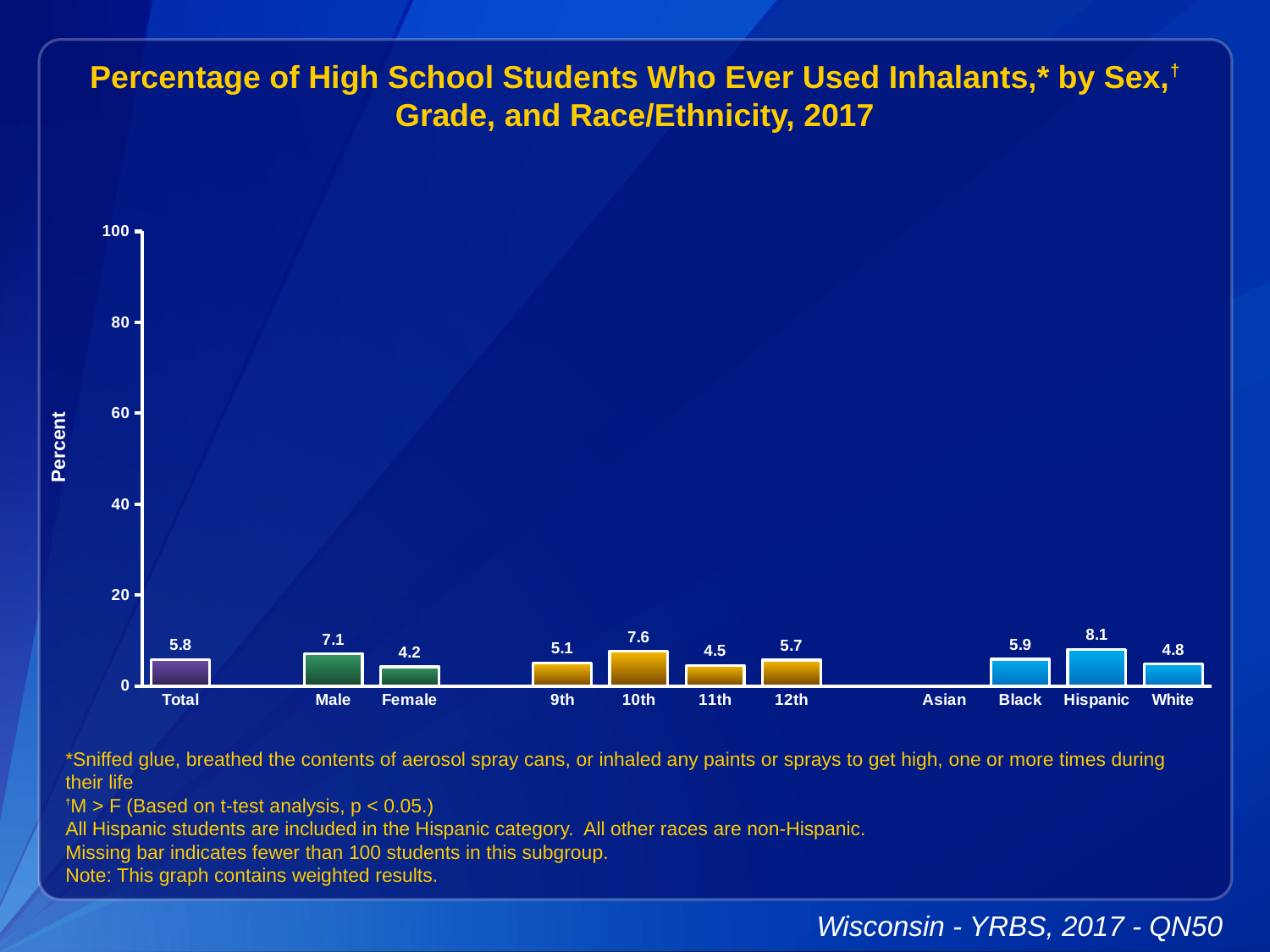
How many categories have a bar plotted? 10 Is the value for Black greater or less than 20? less What is the value for Hispanic? 8.1 What is the value for 10th grade? 7.6 What is the difference between the Male and Female values? 2.9 What is the value for Male? 7.1 Which category has the lowest plotted value? Female What is the value for Total? 5.8 Which category has no bar shown? Asian Which is larger, the value for 9th grade or 12th grade? 12th Which category has the highest value? Hispanic What kind of chart is this? bar chart